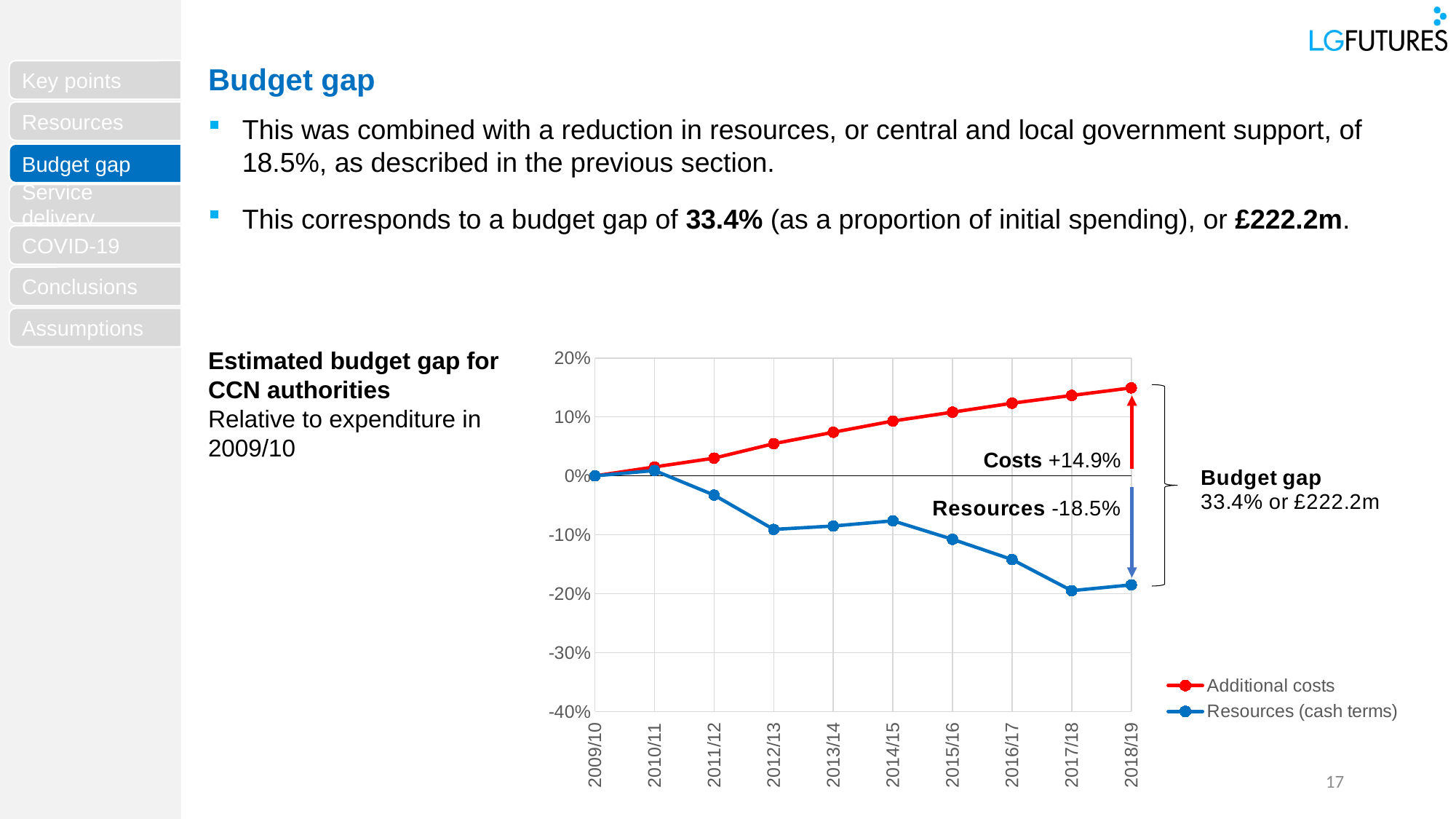
What is the value of Resources (cash terms) in 2018/19 according to the annotation on the chart? -18.5% Do the values for Additional costs rise or fall from 2009/10 to 2018/19? Rise What budget gap is annotated on the chart for 2018/19? 33.4% or £222.2m Do the values for Resources (cash terms) rise or fall from 2009/10 to 2018/19? Fall How many years are plotted along the x axis of the chart? 10 What colour is the line for Additional costs in the chart? Red In which year is the Additional costs series at its highest? 2018/19 What kind of chart is shown on the slide? Line chart Is the value for Additional costs in 2016/17 greater or less than 10%? greater What is the value of Additional costs in 2018/19 according to the annotation on the chart? +14.9% How many series does the chart legend list? 2 Is the value for Resources (cash terms) in 2017/18 greater or less than -10%? less